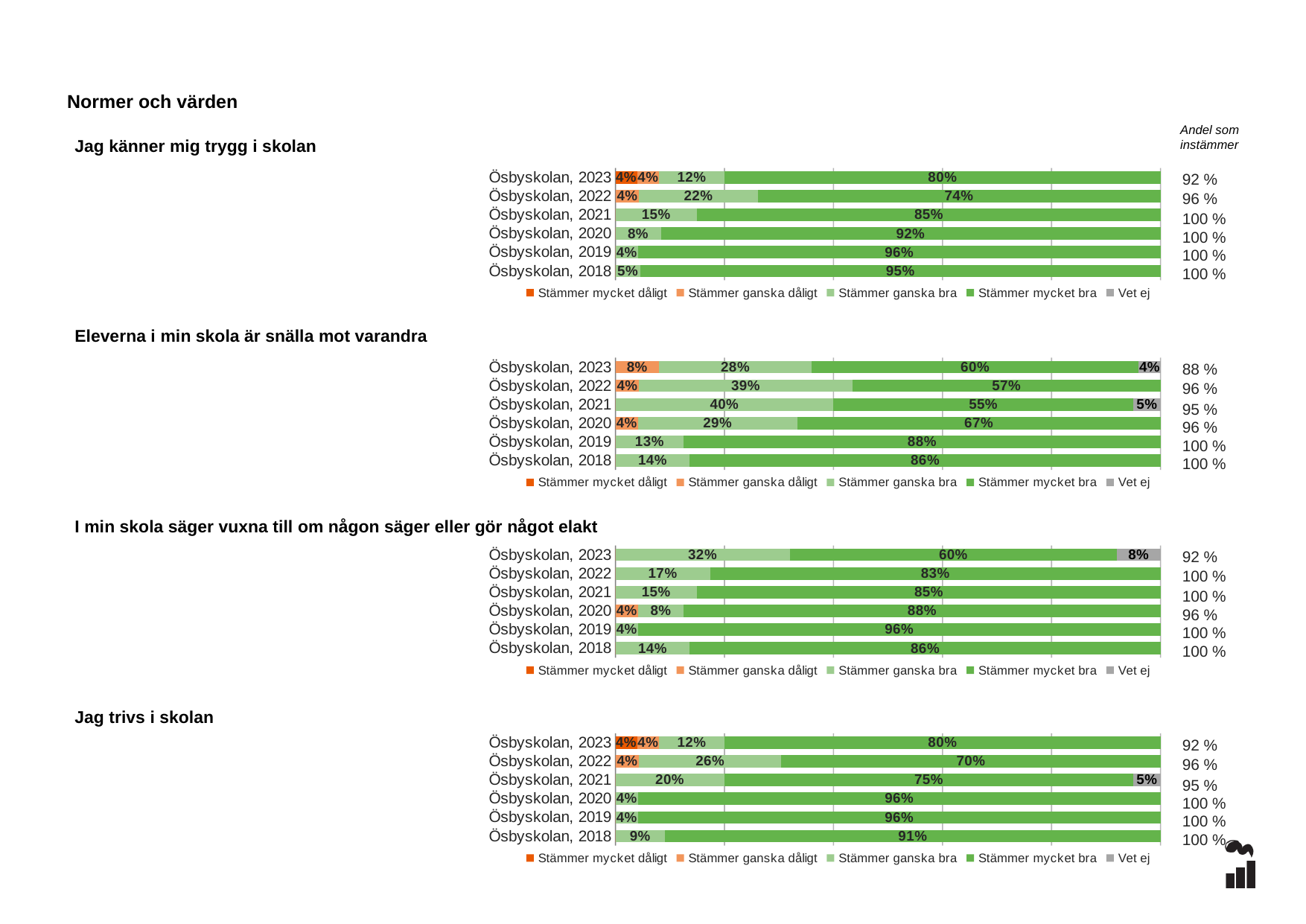
How many series does the legend list for the chart 'Jag trivs i skolan'? 5 In the chart 'I min skola säger vuxna till om någon säger eller gör något elakt', what is the 'Vet ej' value for Ösbyskolan, 2023? 8% How many bars (years) are shown in the chart 'Jag känner mig trygg i skolan'? 6 In the chart 'Jag känner mig trygg i skolan', what is the 'Stämmer mycket bra' value for Ösbyskolan, 2023? 80% In the chart 'Eleverna i min skola är snälla mot varandra', which year has the highest 'Stämmer mycket bra' value? Ösbyskolan, 2019 In the chart 'Jag känner mig trygg i skolan', what is the 'Stämmer ganska bra' value for Ösbyskolan, 2022? 22% In the chart 'Jag trivs i skolan', which year has the lowest 'Stämmer mycket bra' value? Ösbyskolan, 2022 In the chart 'Eleverna i min skola är snälla mot varandra', what is the 'Vet ej' value for Ösbyskolan, 2021? 5% What kind of chart is used for 'Eleverna i min skola är snälla mot varandra'? Stacked bar chart In the chart 'I min skola säger vuxna till om någon säger eller gör något elakt', which is larger: the 'Stämmer mycket bra' value for Ösbyskolan, 2022 or for Ösbyskolan, 2019? Ösbyskolan, 2019 In the chart 'Eleverna i min skola är snälla mot varandra', what is the difference between the 'Stämmer ganska bra' values for Ösbyskolan, 2021 and Ösbyskolan, 2023? 12% In the chart 'Jag trivs i skolan', what is the 'Stämmer mycket bra' value for Ösbyskolan, 2021? 75%